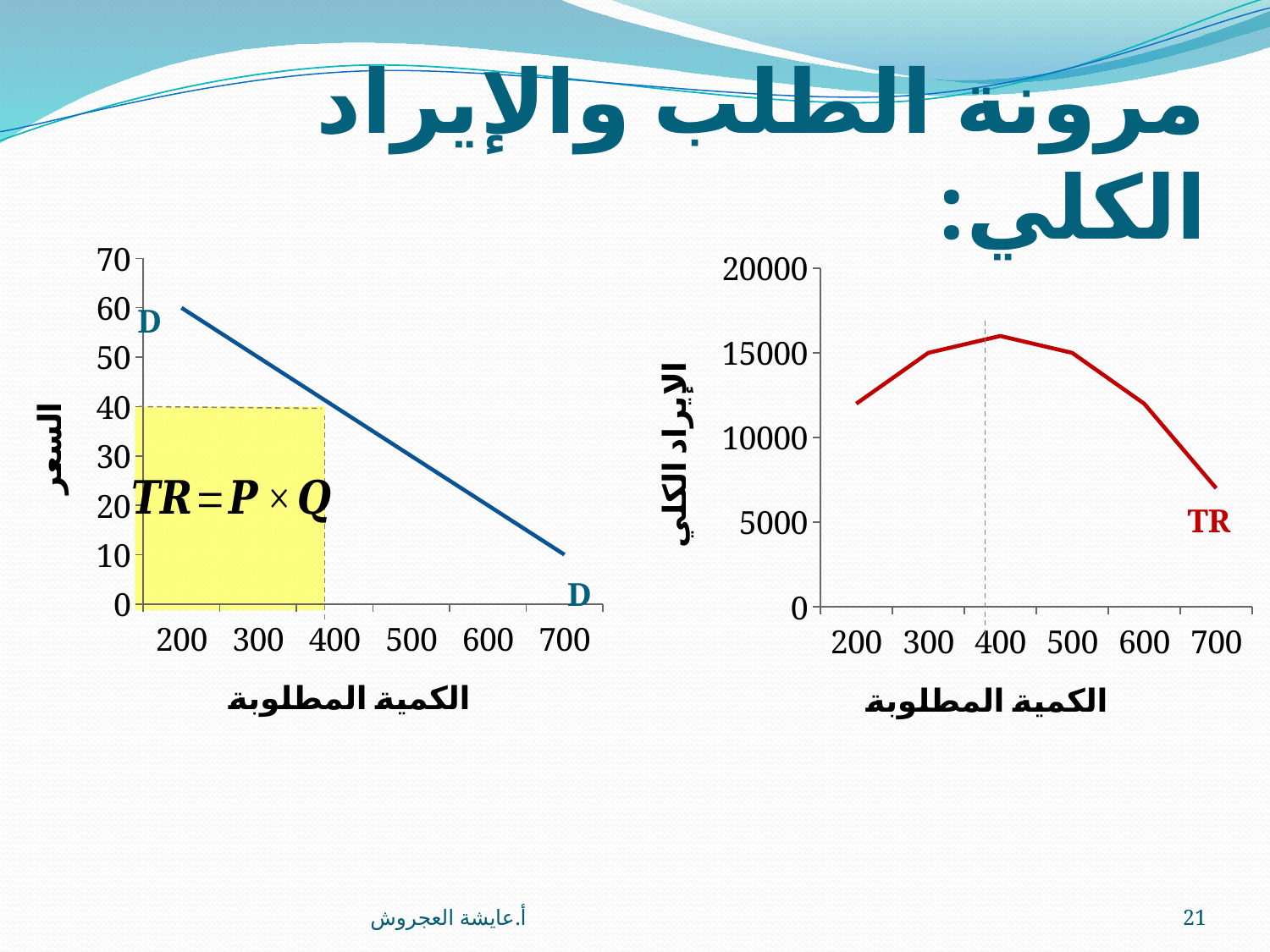
In the right chart, is the TR value at quantity 700 greater or less than 10000? less In the right chart, which is larger: TR at quantity 200 or TR at quantity 700? TR at quantity 200 What is the label of the y axis on the right chart? الإيراد الكلي In the left chart, does the price rise or fall as the quantity demanded increases along the x axis? fall In the left chart, what is the price when the quantity demanded is 700? 10 What kind of chart is the left chart? line chart In the right chart, at which quantity is total revenue (TR) highest? 400 In the right chart, at which quantity is total revenue (TR) lowest? 700 How many quantity values are marked on the x axis of the right chart? 6 In the left chart, what is the price (السعر) when the quantity demanded is 200? 60 In the right chart, is the TR value at quantity 400 greater or less than 15000? greater In the left chart, what price corresponds to a quantity of 400 (the corner of the shaded rectangle)? 40